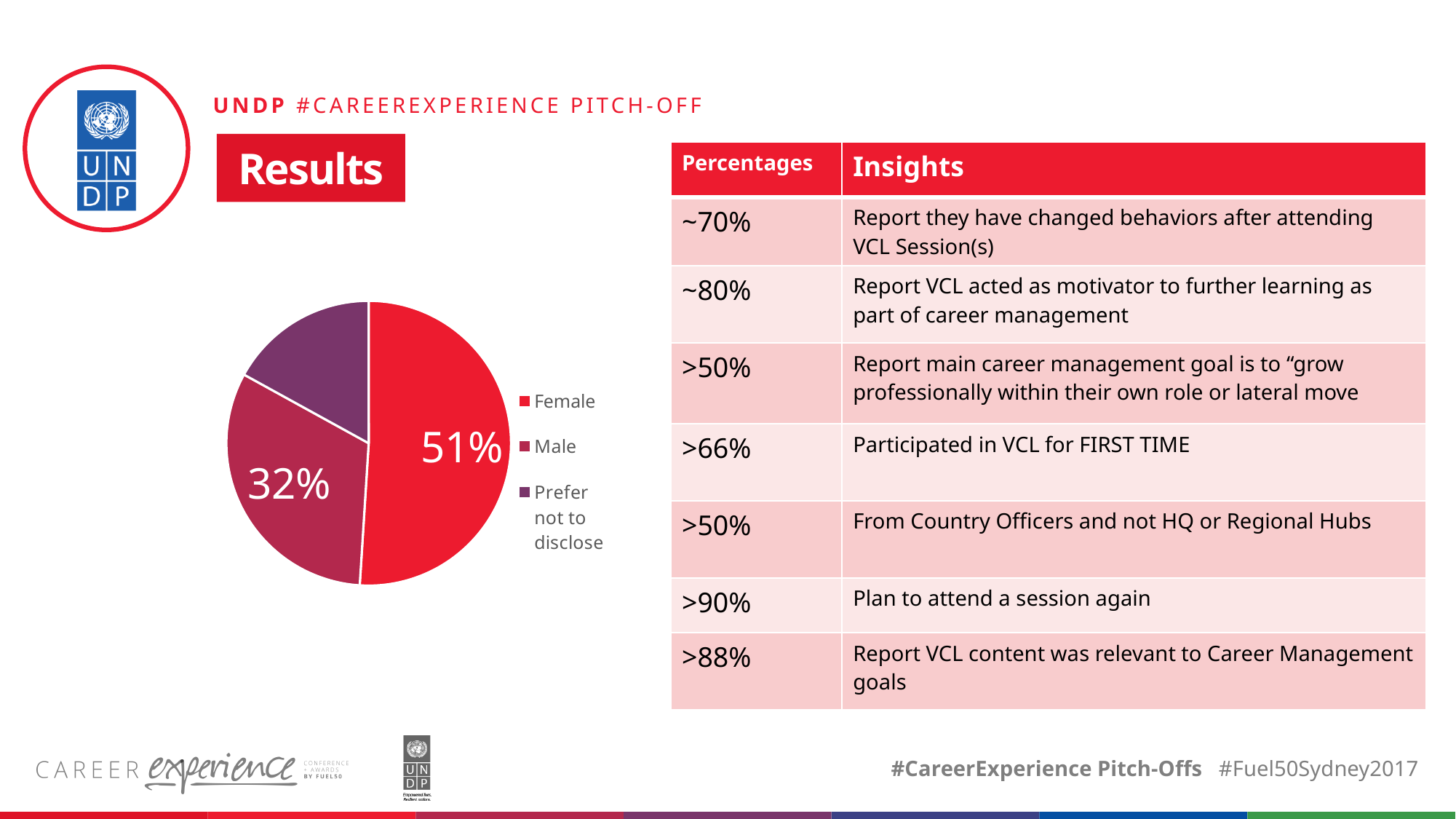
Which category has the largest slice of the pie chart? Female Which category has the smallest slice of the pie chart? Prefer not to disclose How many entries does the pie chart legend list? 3 What share of the pie does the Male slice represent? 32% What percentage of the pie chart is Female? 51% Which category is shown in bright red in the pie chart? Female How many categories does the pie chart show? 3 What percentage of the pie chart is Male? 32% What kind of chart is shown on the slide? Pie chart Which slice is larger, Female or Male? Female What is the difference in percentage points between the Female and Male slices? 19 Which category is shown in the darkest purple colour in the pie chart? Prefer not to disclose